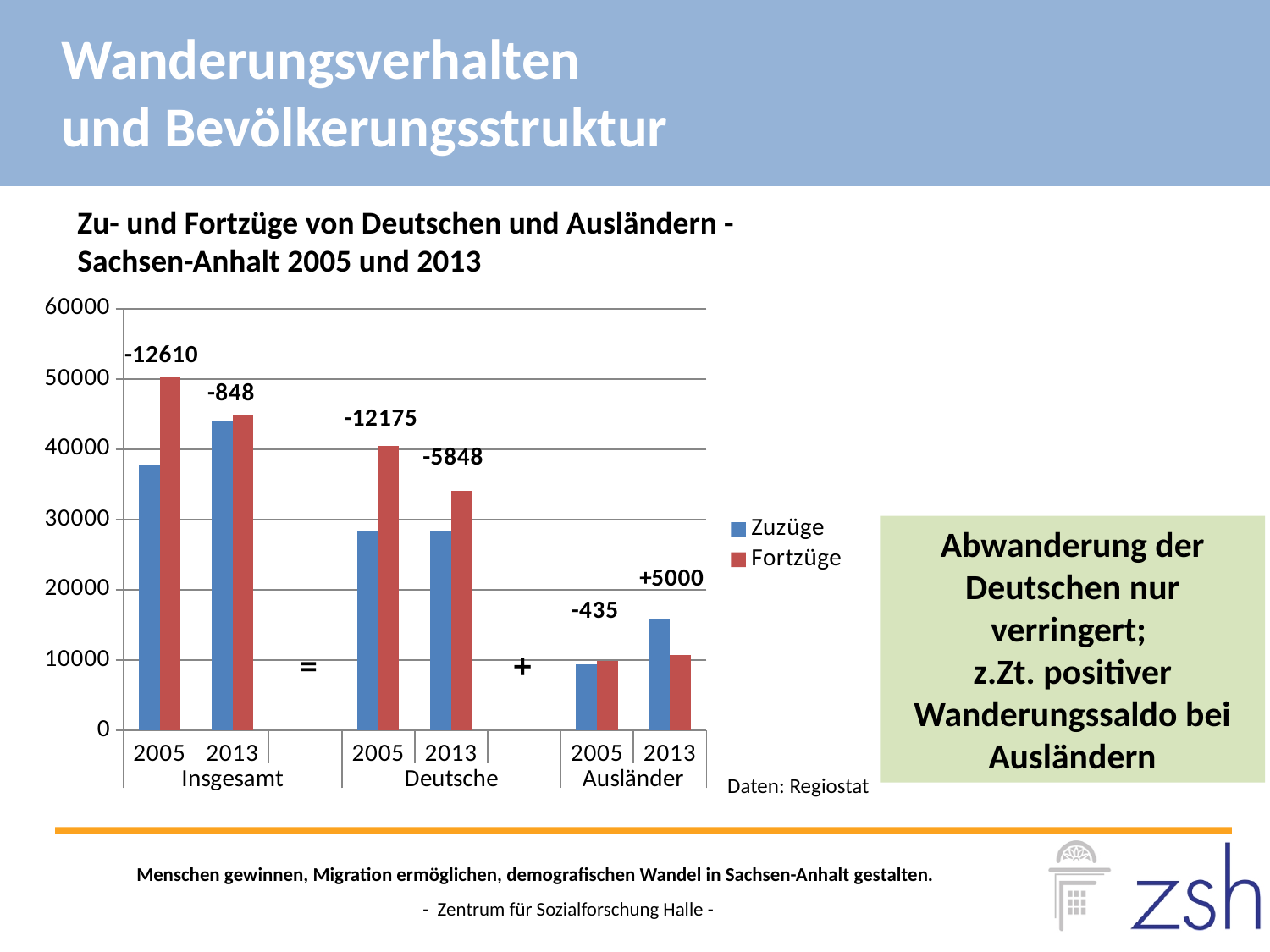
For Insgesamt 2005, which is larger: Zuzüge or Fortzüge? Fortzüge Is the Zuzüge value for Ausländer 2013 greater or less than 10000? greater What kind of chart is shown on the slide? bar chart What net balance is printed above the Ausländer 2013 bars? +5000 For Ausländer 2013, which is larger: Zuzüge or Fortzüge? Zuzüge How many series does the legend list? 2 How many year groups (pairs of bars) are plotted in the chart? 6 What net balance is printed above the Insgesamt 2005 bars? -12610 Is the Zuzüge value for Insgesamt 2005 greater or less than 30000? greater Did the Fortzüge value for Deutsche rise or fall from 2005 to 2013? fall Is the Fortzüge value for Insgesamt 2005 greater or less than 40000? greater What net balance is printed above the Deutsche 2013 bars? -5848